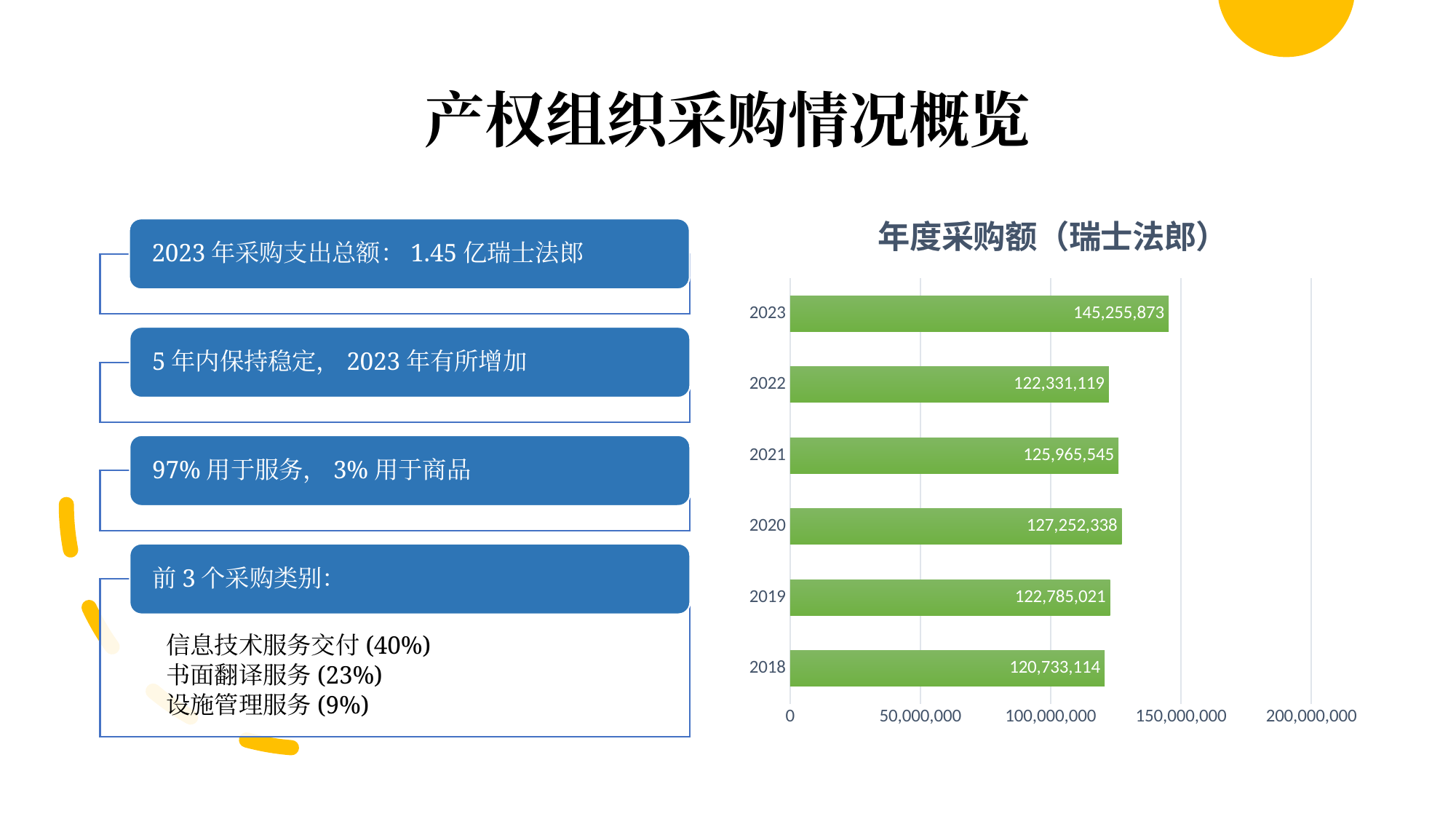
How many years are shown in the chart? 6 Is the value for 2023 greater or less than 150,000,000? less Which year has the highest procurement value? 2023 What is the annual procurement value for 2018? 120,733,114 Which year has the lowest procurement value? 2018 What is the annual procurement value for 2020? 127,252,338 What is the difference between the 2023 and 2022 procurement values? 22,924,754 What is the difference between the 2019 and 2018 procurement values? 2,051,907 What type of chart is shown on the slide? Bar chart What is the title of the chart? 年度采购额（瑞士法郎） Which is larger, the procurement value for 2020 or for 2021? 2020 What is the annual procurement value for 2023? 145,255,873